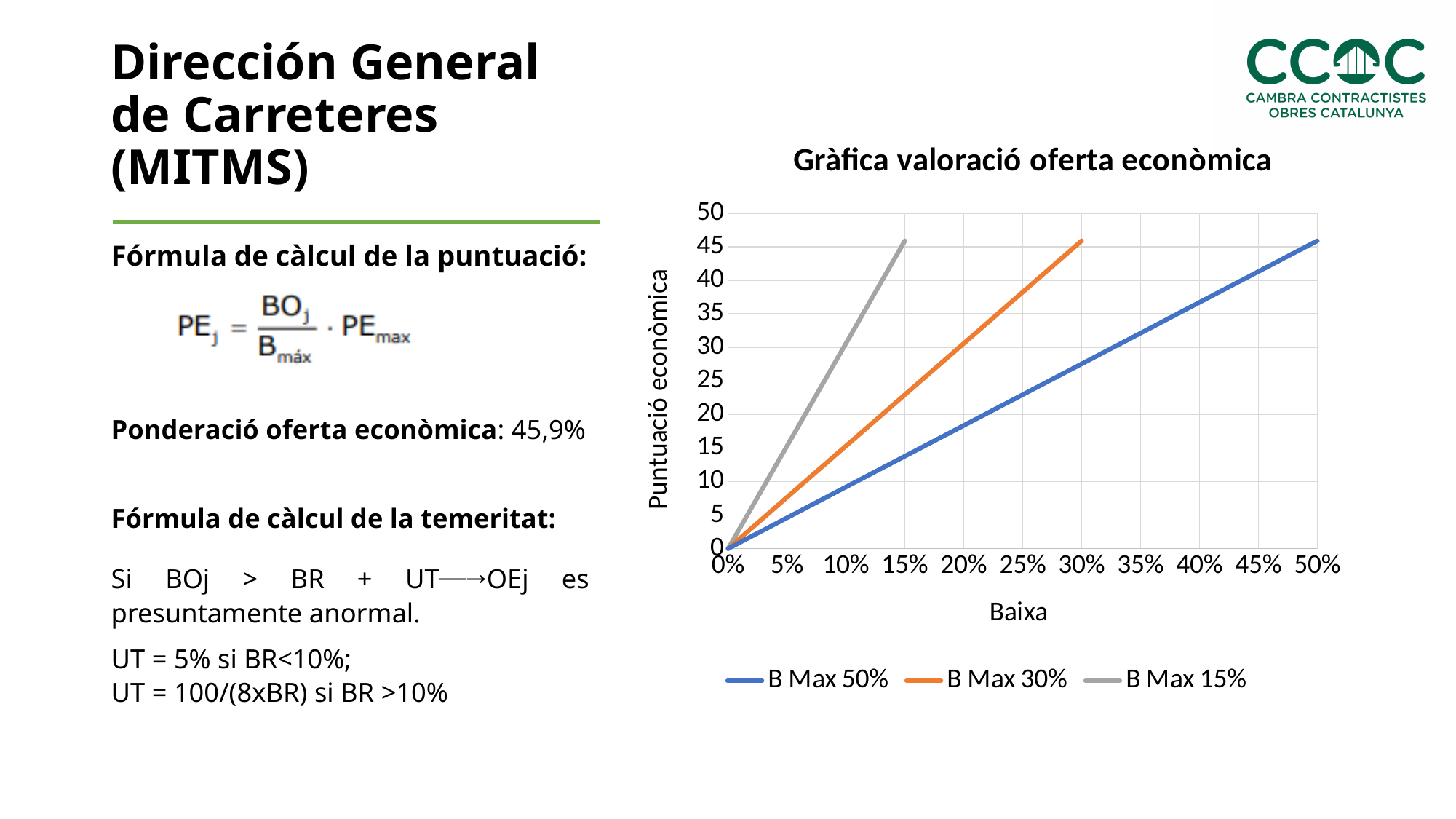
Is the value of the B Max 50% series at a Baixa of 10% greater or less than 15? less Is the value of the B Max 50% series at a Baixa of 25% greater or less than 20? greater Which series extends to the largest Baixa value on the x axis? B Max 50% Is the value of the B Max 30% series at a Baixa of 15% greater or less than 20? greater At a Baixa of 10%, which series has the higher value, B Max 15% or B Max 50%? B Max 15% What is the label of the vertical axis of the chart? Puntuació econòmica What is the Puntuació econòmica value of the B Max 50% series at a Baixa of 0%? 0 What is the title of the chart? Gràfica valoració oferta econòmica Do the values of the B Max 30% series rise or fall as Baixa increases? rise How many series does the legend of the chart list? 3 What kind of chart is shown on the slide? line chart